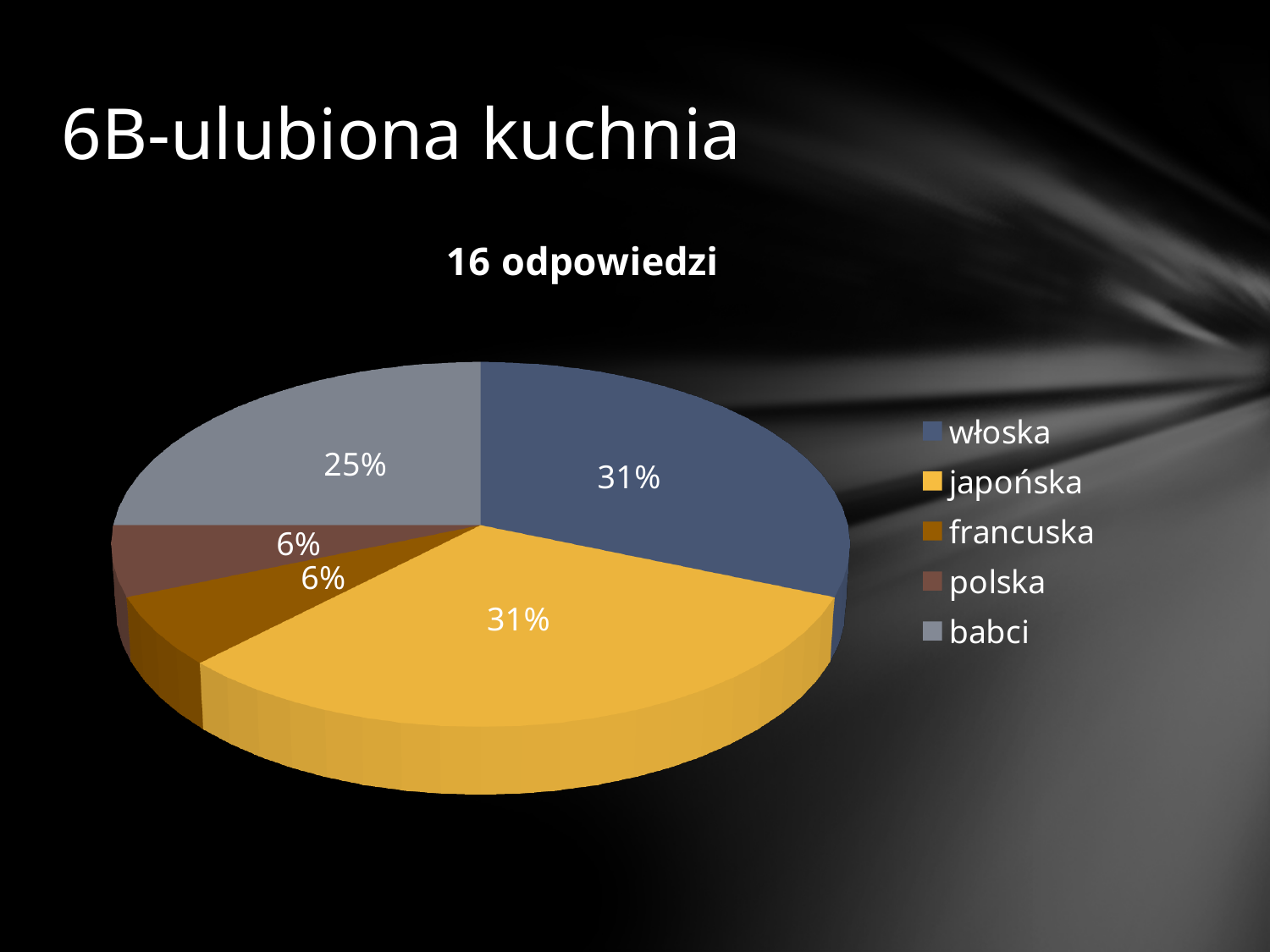
Which is larger, the share for japońska or the share for babci? japońska What is the title of the chart? 16 odpowiedzi Which is larger, the share for polska or the share for włoska? włoska What share of the pie does francuska have? 6% What is the difference between the share for włoska and the share for babci? 6% What share of the pie does włoska have? 31% How many slices does the pie chart have? 5 What share of the pie does polska have? 6% What share of the pie does japońska have? 31% What share of the pie does babci have? 25% What is the difference between the share for babci and the share for francuska? 19% What kind of chart is shown on the slide? pie chart